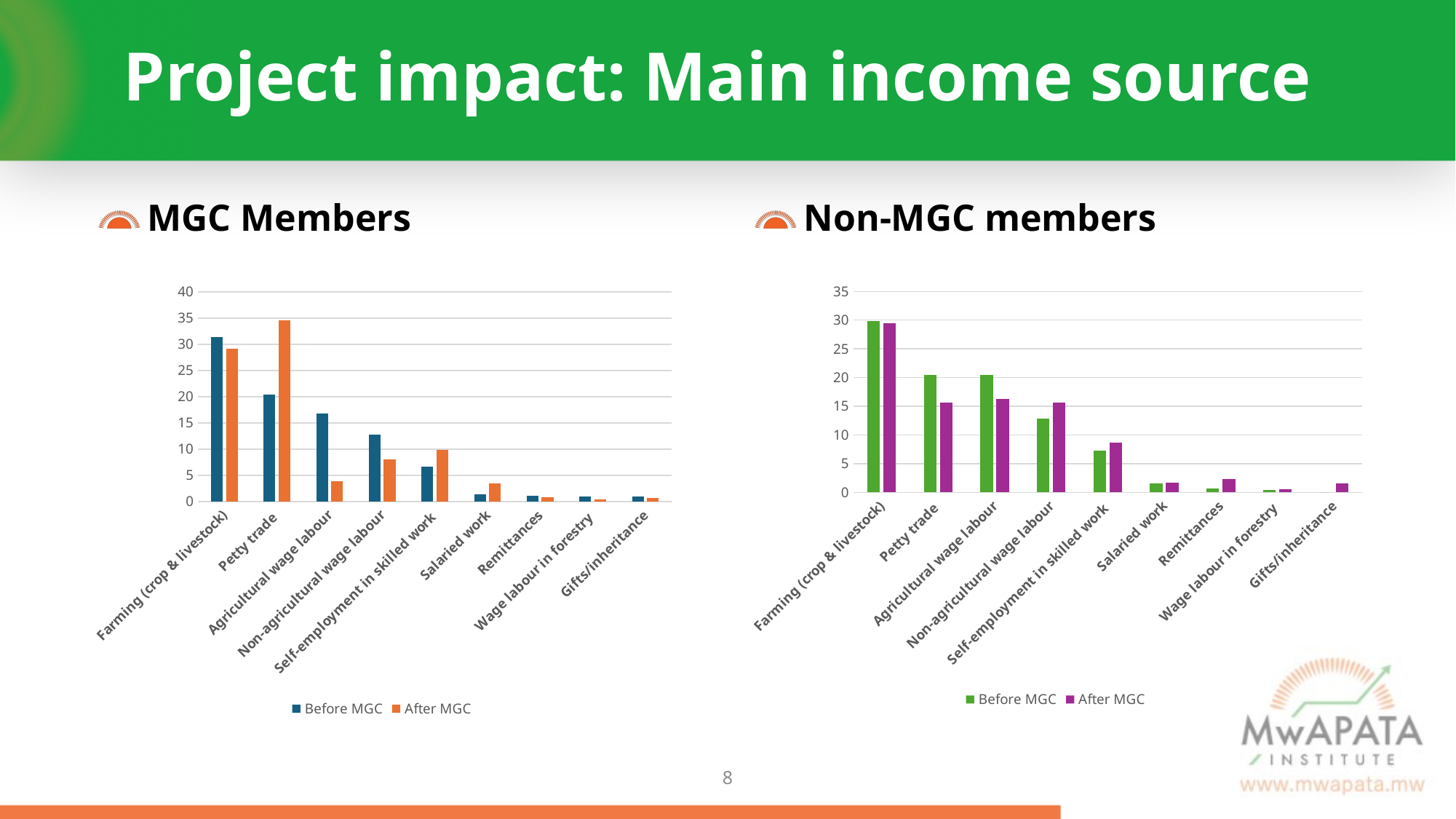
What colour are the After MGC bars in the Non-MGC members chart? purple In the MGC Members chart, is the After MGC value for Agricultural wage labour greater or less than 5? less In the MGC Members chart, which category has the highest Before MGC value? Farming (crop & livestock) In the Non-MGC members chart, which is larger for Petty trade: the Before MGC value or the After MGC value? Before MGC In the MGC Members chart, which is larger for Self-employment in skilled work: the Before MGC value or the After MGC value? After MGC In the Non-MGC members chart, is the Before MGC value for Farming (crop & livestock) greater or less than 25? greater What kind of chart is the Non-MGC members chart? bar chart How many series does the legend of the Non-MGC members chart list? 2 In the MGC Members chart, is the After MGC value for Petty trade greater or less than 30? greater In the MGC Members chart, which category has the highest After MGC value? Petty trade How many categories are shown on the x axis of the MGC Members chart? 9 In the Non-MGC members chart, which category has the highest Before MGC value? Farming (crop & livestock)